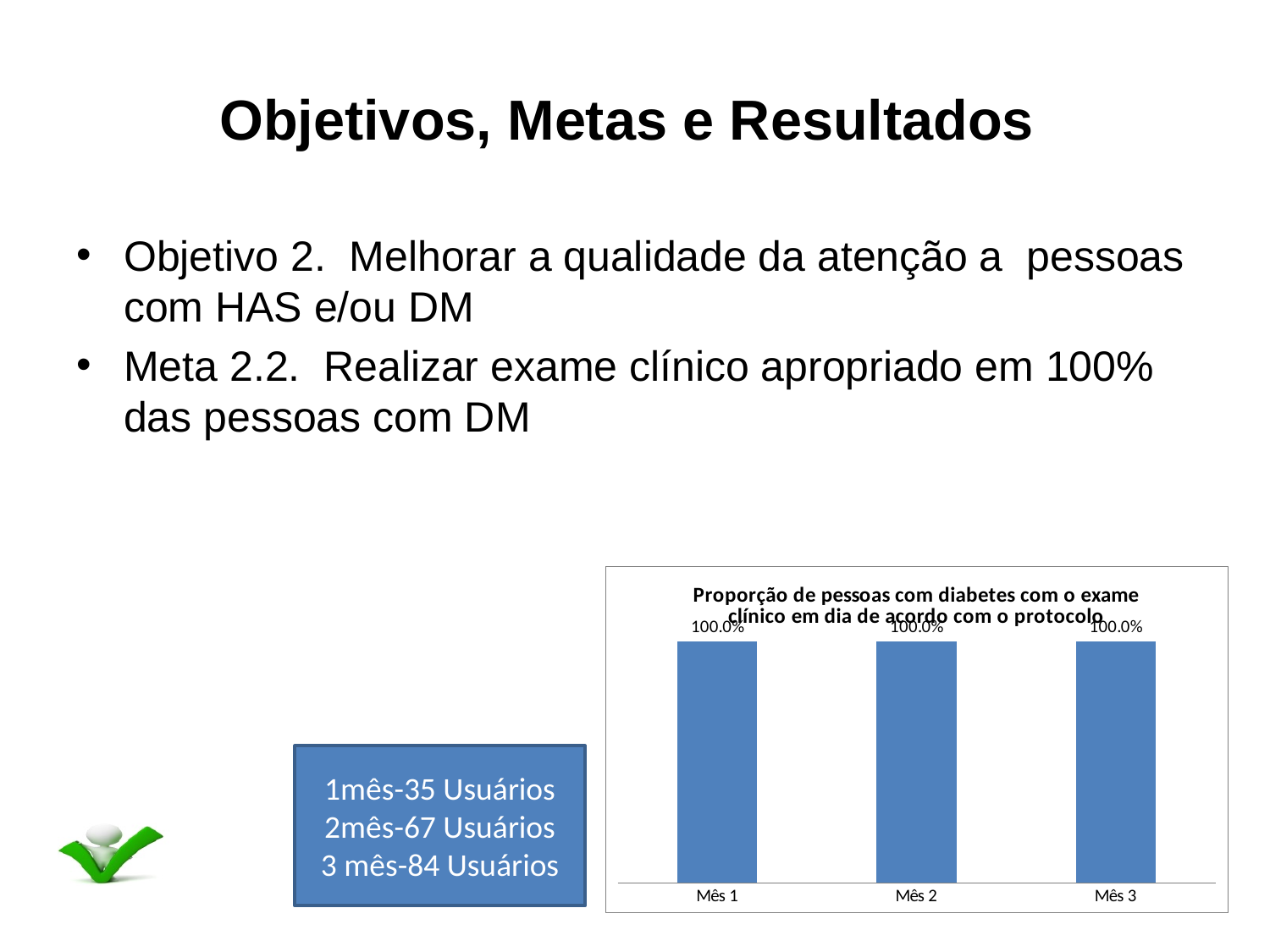
What is the label of the first category on the x axis of the chart? Mês 1 What is the value for Mês 1 in the chart? 100.0% What is the title of the chart? Proporção de pessoas com diabetes com o exame clínico em dia de acordo com o protocolo What is the value for Mês 3 in the chart? 100.0% What colour are the bars in the chart? Blue What kind of chart is shown on the slide? Bar chart How many categories are shown on the x axis of the chart? 3 What is the value for Mês 2 in the chart? 100.0% What is the difference between the values for Mês 3 and Mês 1? 0.0% Do the values rise, fall or stay the same from Mês 1 to Mês 3? Stay the same